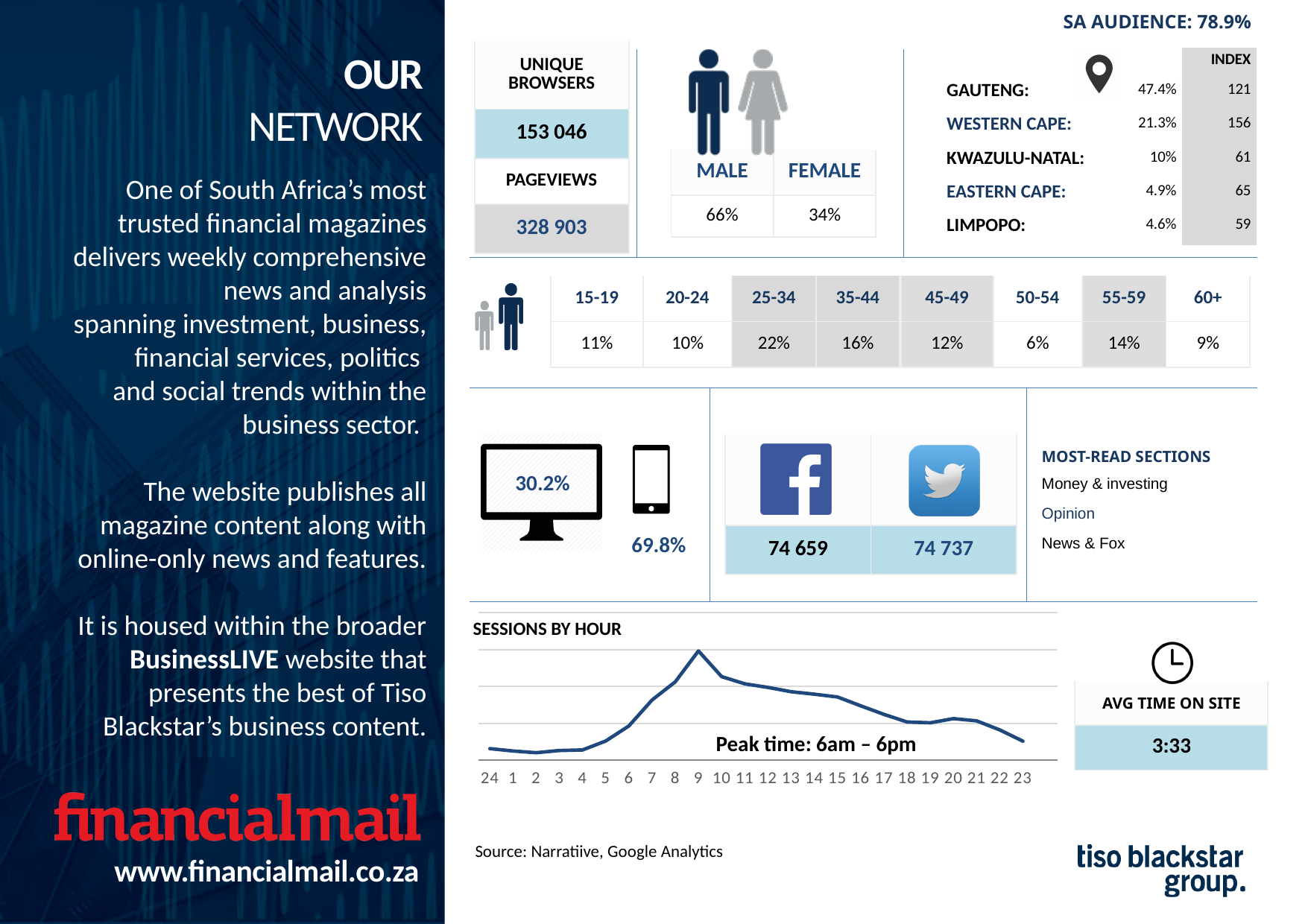
What peak time is annotated on the 'Sessions by hour' chart? 6am – 6pm In the 'Sessions by hour' chart, which hour has more sessions, 1 or 15? 15 In the 'Sessions by hour' chart, which hour has more sessions, 12 or 20? 12 In the 'Sessions by hour' chart, which hour has more sessions, 9 or 3? 9 In the 'Sessions by hour' chart, do sessions rise or fall between hour 3 and hour 9? rise In the 'Sessions by hour' chart, at which hour do sessions reach their highest point? 9 What kind of chart is the 'Sessions by hour' chart? line chart How many hourly points are labelled on the x axis of the 'Sessions by hour' chart? 24 In the 'Sessions by hour' chart, do sessions rise or fall between hour 9 and hour 23? fall What is the title of the line chart on the slide? SESSIONS BY HOUR